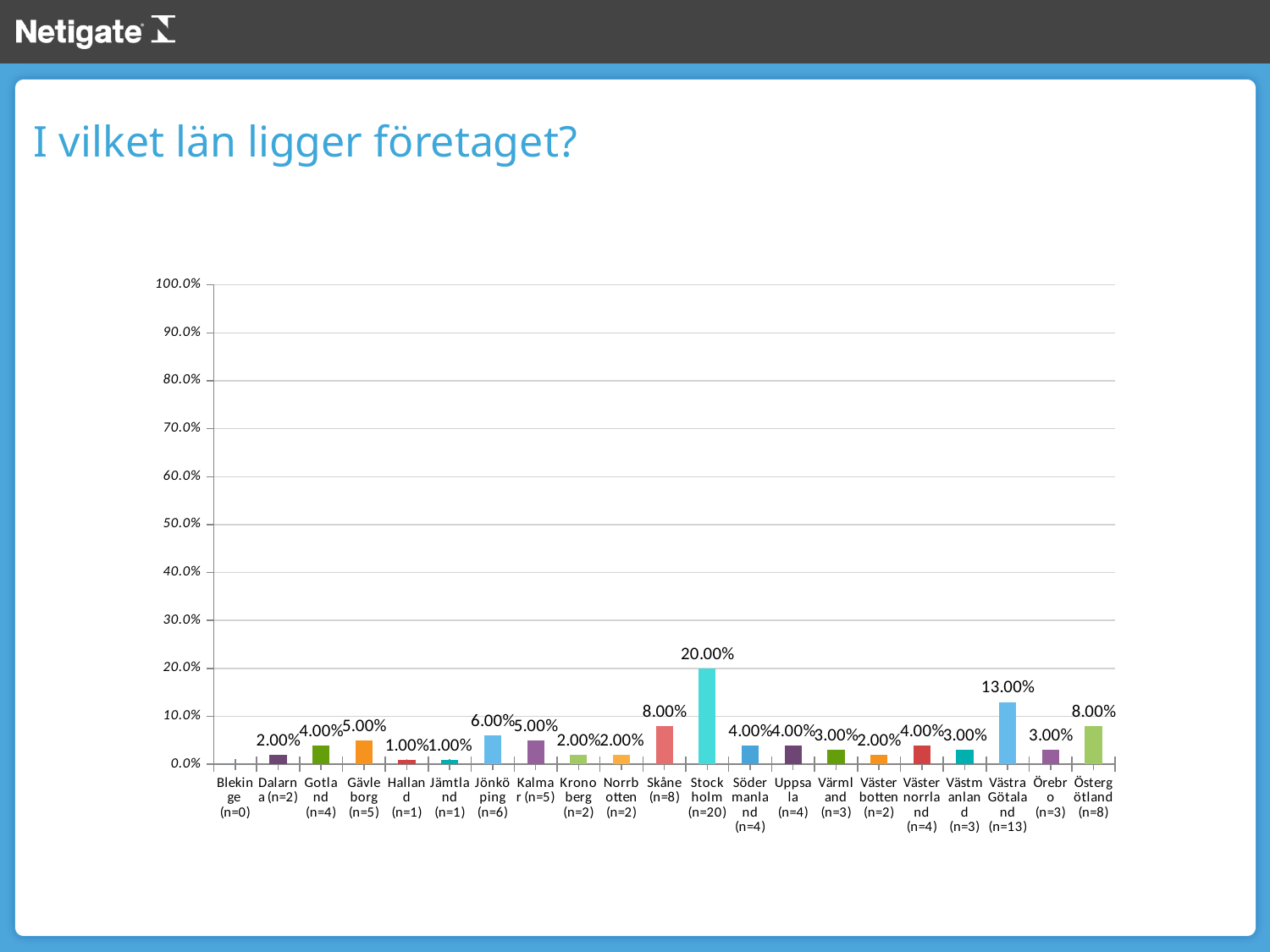
What is the difference between the values for Östergötland and Örebro? 5.00% Is the value for Stockholm greater or less than 30%? less What is the value for Skåne? 8.00% What is the value for Jönköping? 6.00% Which is larger, the value for Gävleborg or the value for Gotland? Gävleborg What is the difference between the values for Stockholm and Västra Götaland? 7.00% How many counties are shown on the x axis? 21 What is the value for Stockholm? 20.00% Which county has the highest value? Stockholm What is the value for Västra Götaland? 13.00% What is the title of the slide? I vilket län ligger företaget? What kind of chart is shown on the slide? bar chart